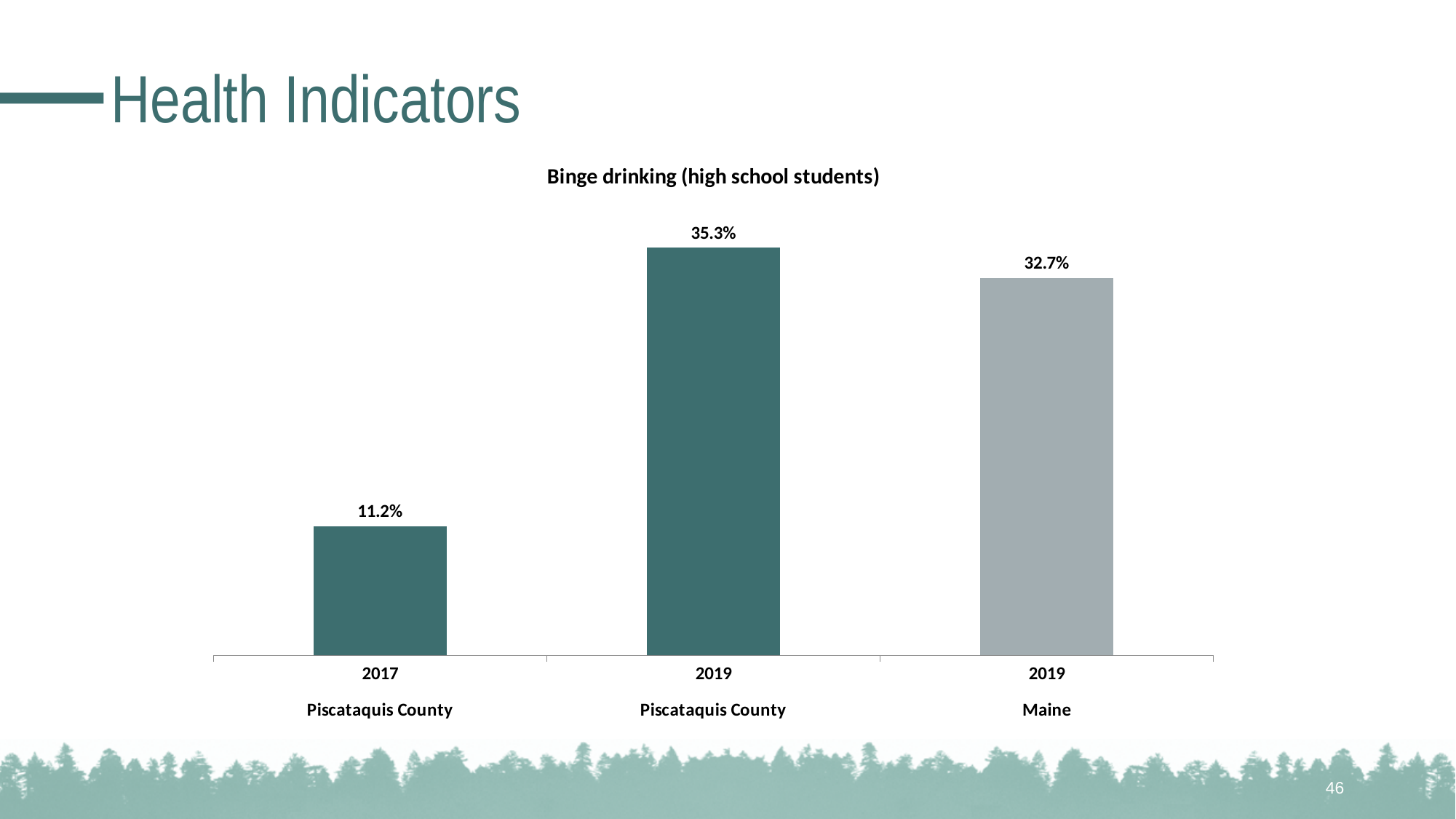
What is the binge drinking rate for Maine high school students in 2019? 32.7% What kind of chart is shown on the slide? Bar chart Did the Piscataquis County binge drinking rate rise or fall from 2017 to 2019? Rise By how many percentage points did the Piscataquis County binge drinking rate change from 2017 to 2019? 24.1 percentage points What is the difference between the Piscataquis County 2019 rate and the Maine 2019 rate? 2.6 percentage points What is the binge drinking rate for Piscataquis County high school students in 2019? 35.3% How many bars are shown in the chart? 3 Which is larger in 2019, the Piscataquis County rate or the Maine rate? Piscataquis County Which bar shows the lowest binge drinking rate? Piscataquis County 2017 What is the title of the chart? Binge drinking (high school students) Which bar shows the highest binge drinking rate? Piscataquis County 2019 What is the binge drinking rate for Piscataquis County high school students in 2017? 11.2%